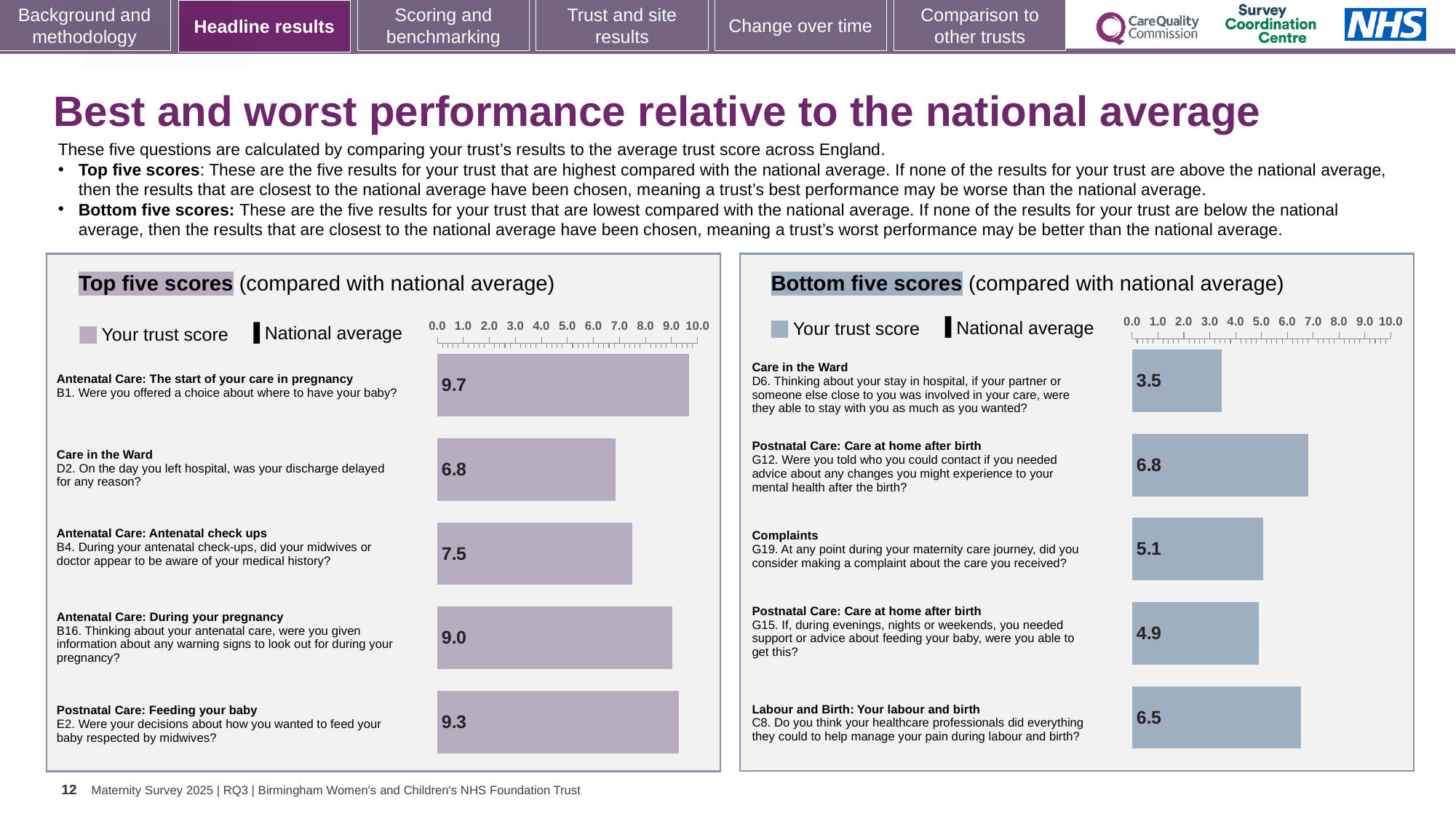
In the Top five scores chart, which question has the lowest trust score? D2 (Care in the Ward) In the Bottom five scores chart, which has the larger trust score: G12 (Postnatal Care: Care at home after birth) or C8 (Labour and Birth)? G12 In the Bottom five scores chart, what is the trust score for D6 (Care in the Ward, partner able to stay with you)? 3.5 In the Top five scores chart, what is the difference between the trust scores for B1 and D2? 2.9 In the Bottom five scores chart, which question has the lowest trust score? D6 (Care in the Ward) In the Bottom five scores chart, what is the trust score for G15 (support or advice about feeding your baby during evenings, nights or weekends)? 4.9 In the Top five scores chart, which question has the highest trust score? B1 (Antenatal Care: The start of your care in pregnancy) In the Top five scores chart, what is the trust score for B1 (Were you offered a choice about where to have your baby)? 9.7 In the Bottom five scores chart, what is the difference between the trust scores for G12 and D6? 3.3 What type of chart is the Bottom five scores chart? Bar chart How many questions are plotted in the Top five scores chart? 5 In the Top five scores chart, what is the trust score for E2 (Postnatal Care: Feeding your baby)? 9.3